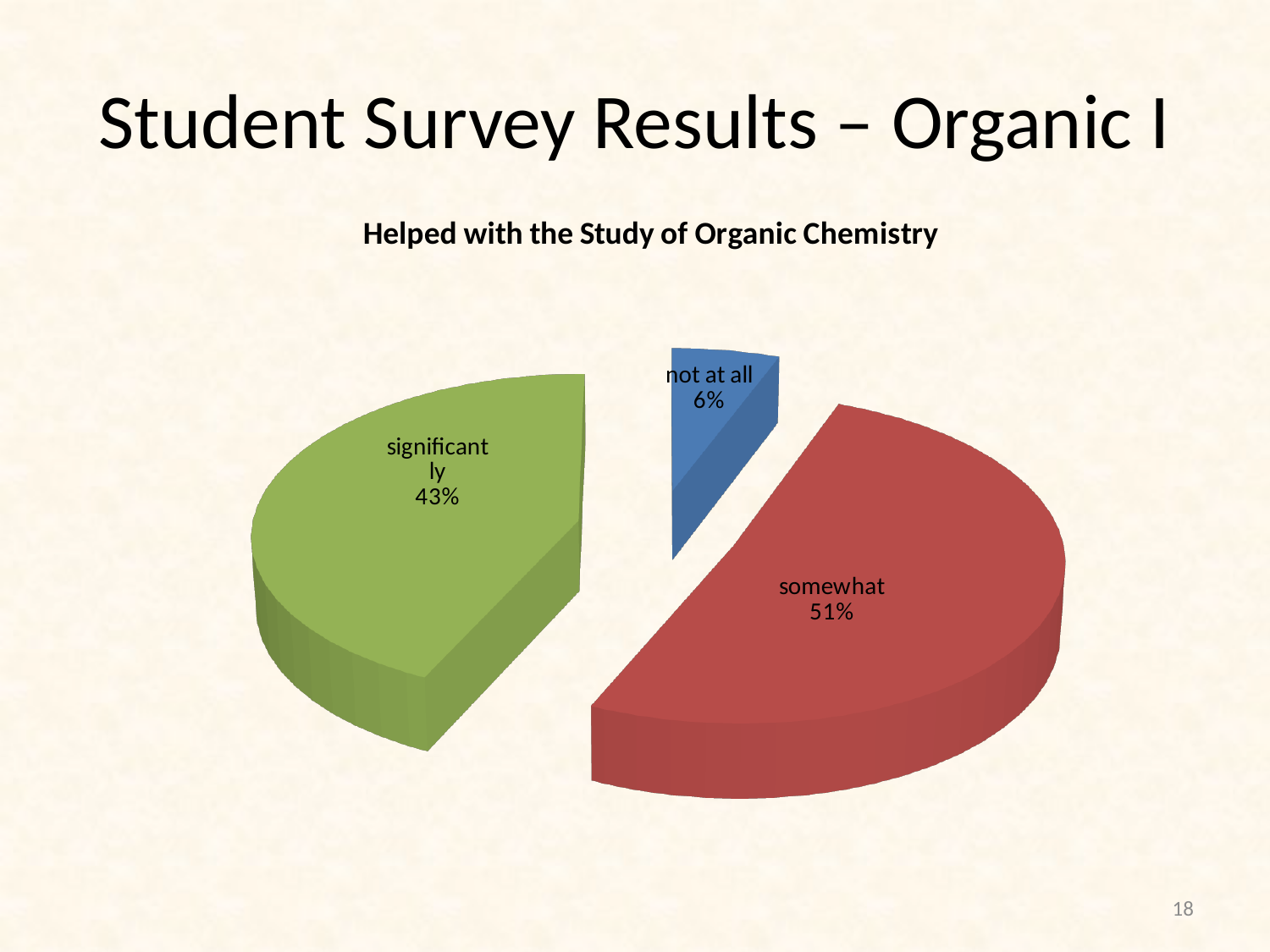
What kind of chart is shown on the slide? pie chart What share of the pie is labelled "not at all"? 6% Which category has the smallest slice of the pie? not at all What colour is the "somewhat" slice? red What is the title of the chart? Helped with the Study of Organic Chemistry How many slices does the pie chart have? 3 What is the difference in percentage points between the "significantly" and "not at all" slices? 37 What share of the pie is labelled "somewhat"? 51% Which category has the largest slice of the pie? somewhat What share of the pie is labelled "significantly"? 43% What is the difference in percentage points between the "somewhat" and "significantly" slices? 8 Which is larger, the "significantly" slice or the "not at all" slice? significantly